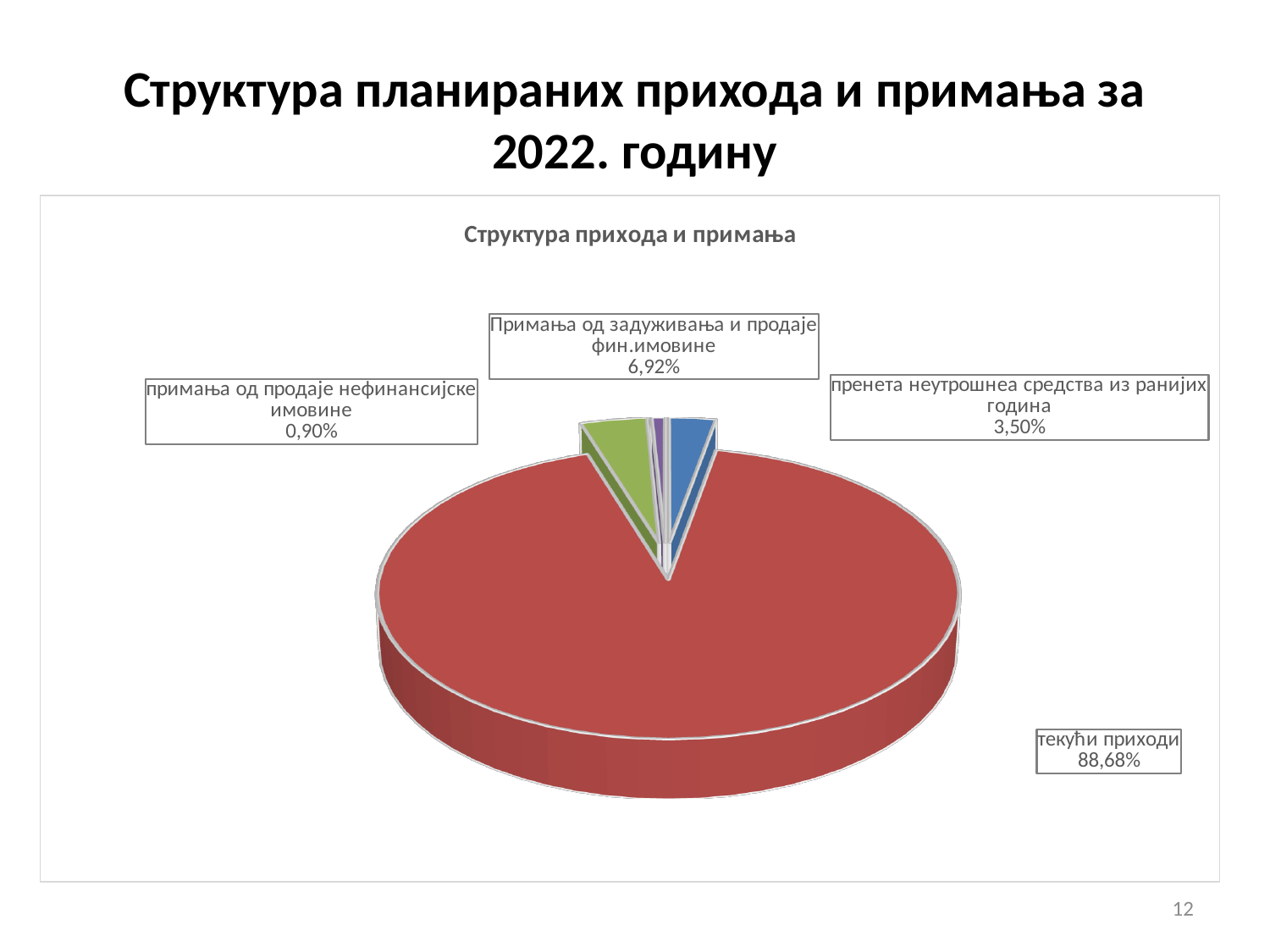
How many slices does the pie chart have? 4 Which category has the smallest slice of the pie? примања од продаје нефинансијске имовине What share of the pie is labelled for примања од продаје нефинансијске имовине? 0,90% What is the title of the chart? Структура прихода и примања What type of chart is shown on the slide? pie chart What share of the pie is labelled for Примања од задуживања и продаје фин.имовине? 6,92% What colour is the slice for текући приходи? red Which is larger: the share for Примања од задуживања и продаје фин.имовине or the share for пренета неутрошнеа средства из ранијих година? Примања од задуживања и продаје фин.имовине What is the difference in percentage points between the share for Примања од задуживања и продаје фин.имовине and the share for пренета неутрошнеа средства из ранијих година? 3,42 What share of the pie is labelled for пренета неутрошнеа средства из ранијих година? 3,50% Which category has the largest slice of the pie? текући приходи What share of the pie is labelled for текући приходи? 88,68%